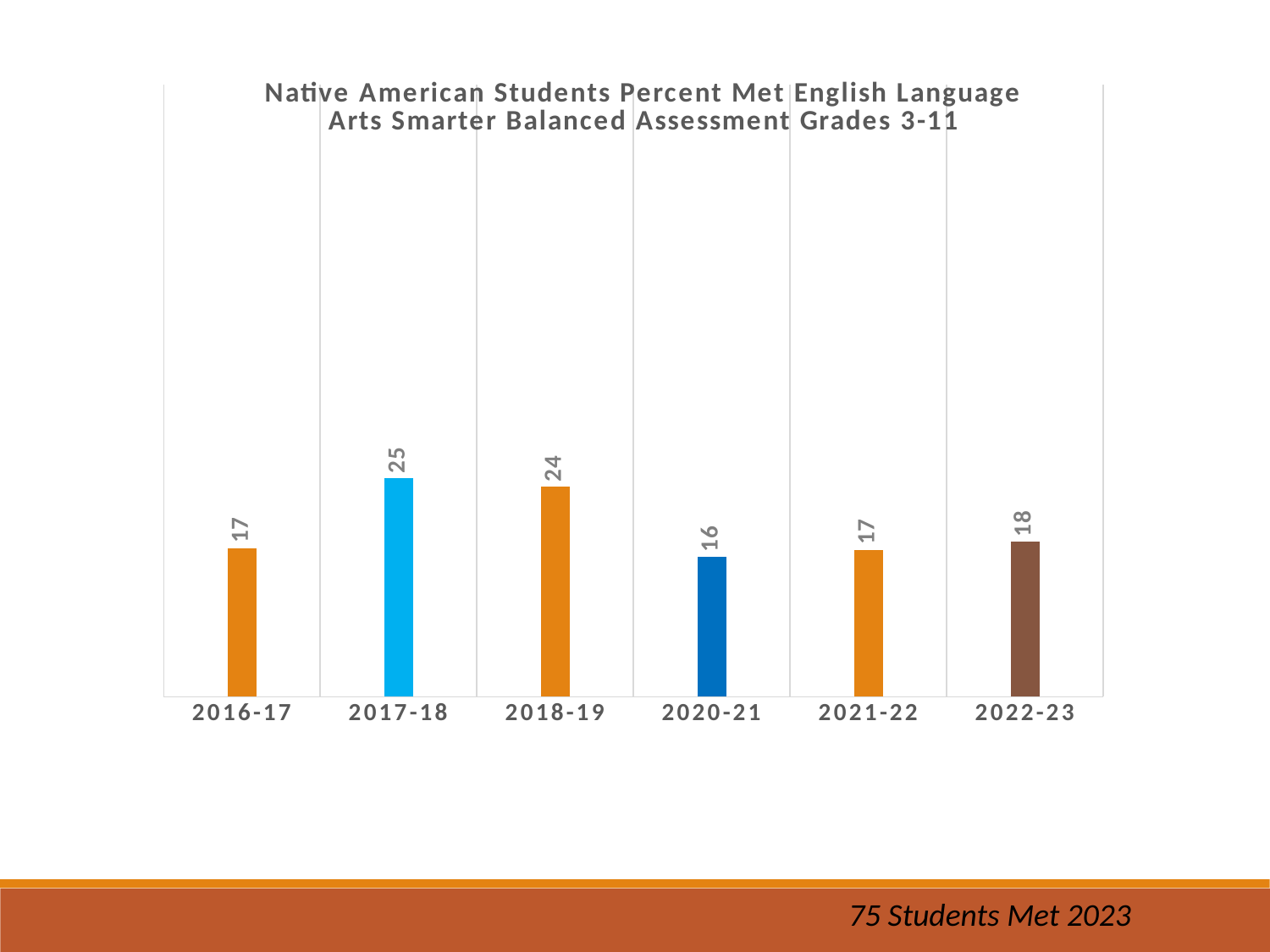
What is the difference between the values for 2017-18 and 2020-21? 9 Which year has the lowest value? 2020-21 Which year has the highest value? 2017-18 What is the title of the chart? Native American Students Percent Met English Language Arts Smarter Balanced Assessment Grades 3-11 What is the value for 2018-19? 24 What kind of chart is this? bar chart What is the value for 2020-21? 16 What is the value for 2017-18? 25 How many years are shown on the x axis? 6 Which is larger, the value for 2016-17 or the value for 2022-23? 2022-23 What is the difference between the values for 2018-19 and 2022-23? 6 What is the value for 2022-23? 18